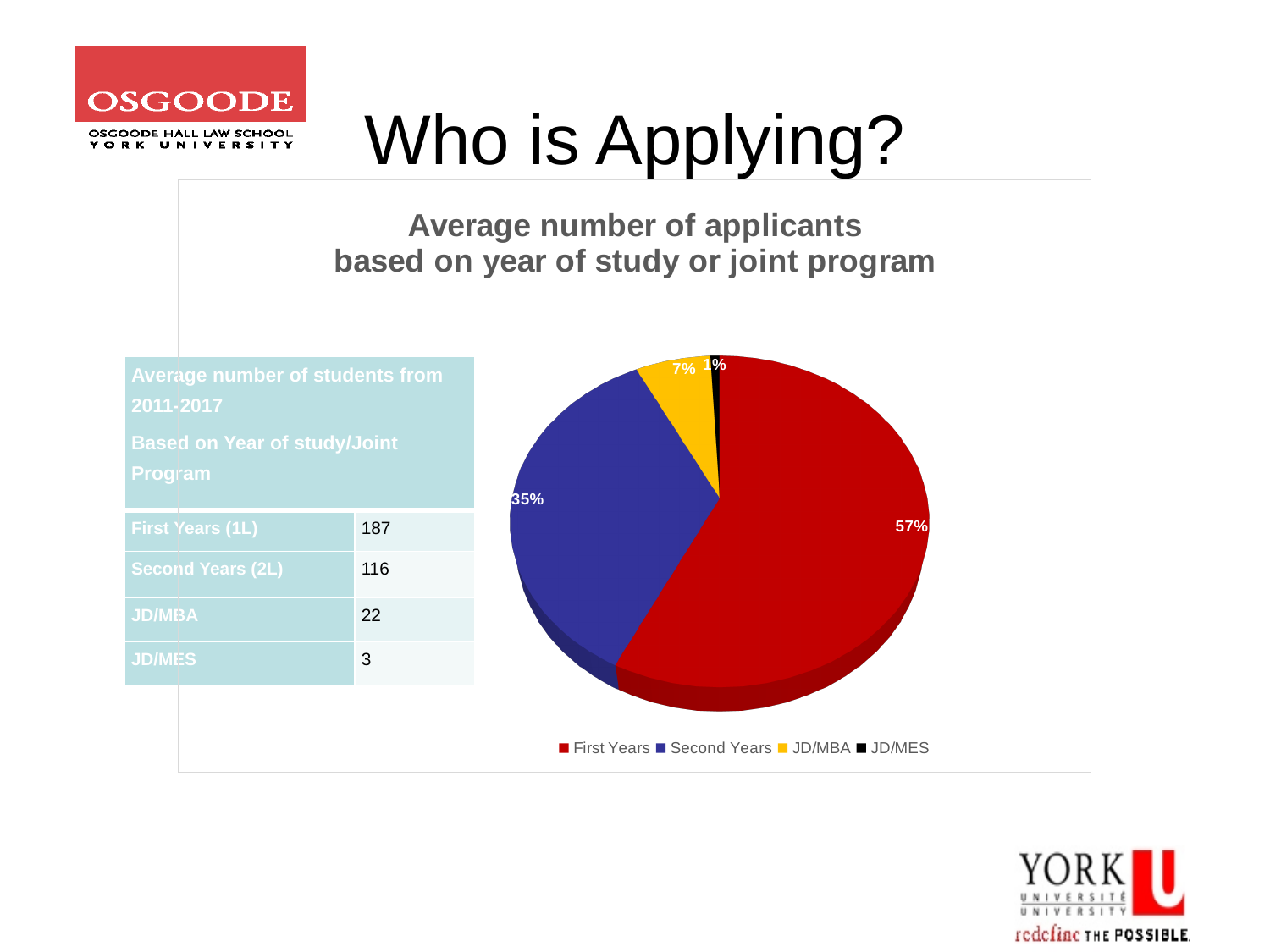
What is the difference in percentage points between the First Years slice and the Second Years slice? 22 percentage points How many slices does the pie chart have? 4 What type of chart is shown on the slide? Pie chart What share of the pie does First Years represent? 57% Which category has the smallest slice of the pie? JD/MES Which category has the largest slice of the pie? First Years Which slice is larger, Second Years or JD/MBA? Second Years What share of the pie does JD/MBA represent? 7% What share of the pie does Second Years represent? 35% How many entries does the legend list? 4 What is the chart's title? Average number of applicants based on year of study or joint program